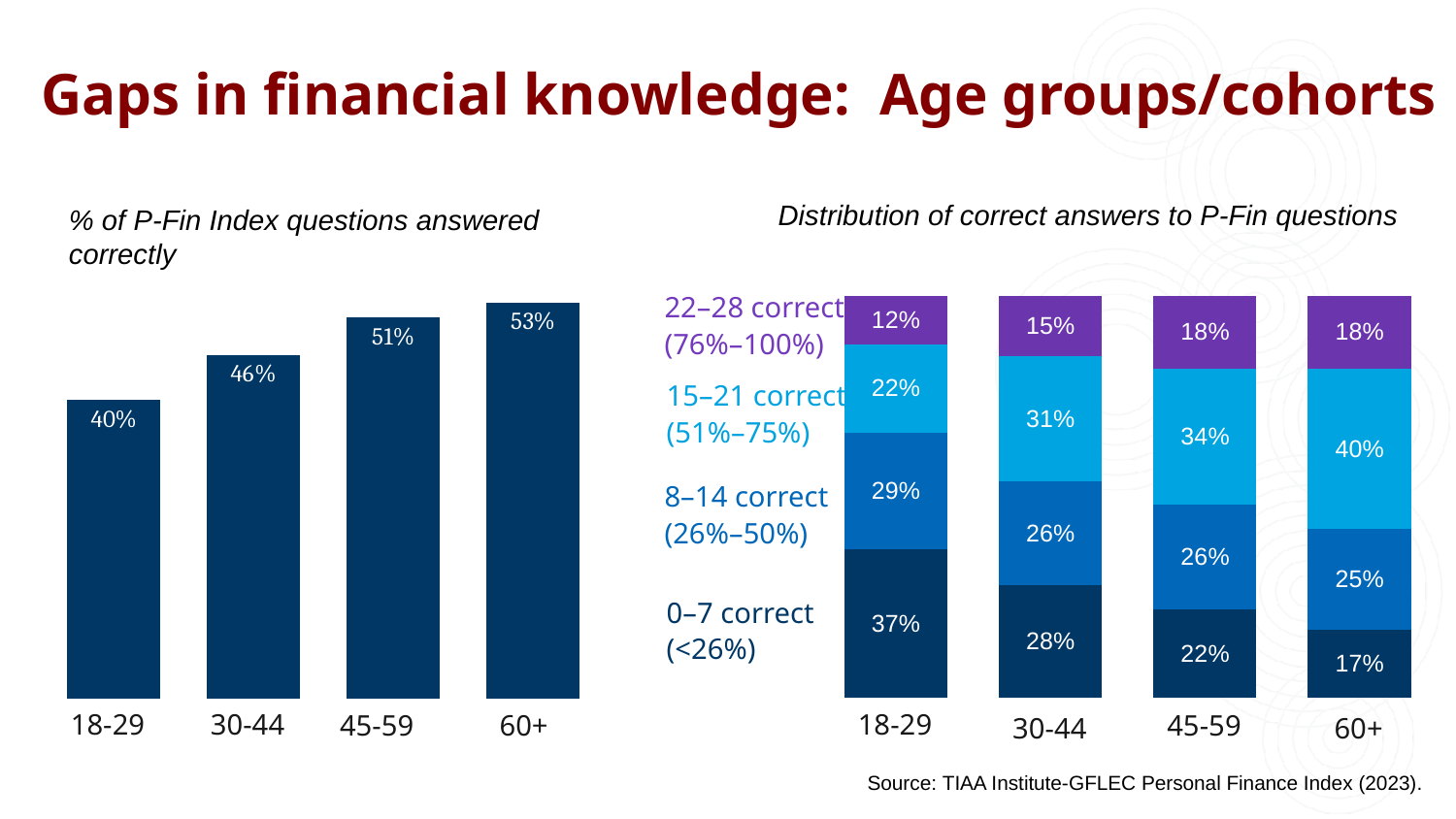
What kind of chart is the right chart, 'Distribution of correct answers to P-Fin questions'? stacked bar chart In the left chart, '% of P-Fin Index questions answered correctly', what is the value for the 30-44 age group? 46% In the left chart, '% of P-Fin Index questions answered correctly', do the values rise or fall as age increases from 18-29 to 60+? rise In the left chart, '% of P-Fin Index questions answered correctly', which age group has the highest value? 60+ In the left chart, '% of P-Fin Index questions answered correctly', what is the difference between the 60+ and 18-29 values? 13 percentage points In the left chart, '% of P-Fin Index questions answered correctly', which age group has the lowest value? 18-29 In the right chart, 'Distribution of correct answers to P-Fin questions', what share of the 18-29 group answered 0–7 questions correctly? 37% In the right chart, 'Distribution of correct answers to P-Fin questions', which age group has the largest share in the 0–7 correct category? 18-29 In the right chart, 'Distribution of correct answers to P-Fin questions', is the 22–28 correct share larger for the 30-44 group or the 45-59 group? 45-59 In the right chart, 'Distribution of correct answers to P-Fin questions', what share of the 60+ group answered 15–21 questions correctly? 40% How many categories of correct-answer ranges does the right chart, 'Distribution of correct answers to P-Fin questions', list? 4 How many age groups are shown in the left chart, '% of P-Fin Index questions answered correctly'? 4